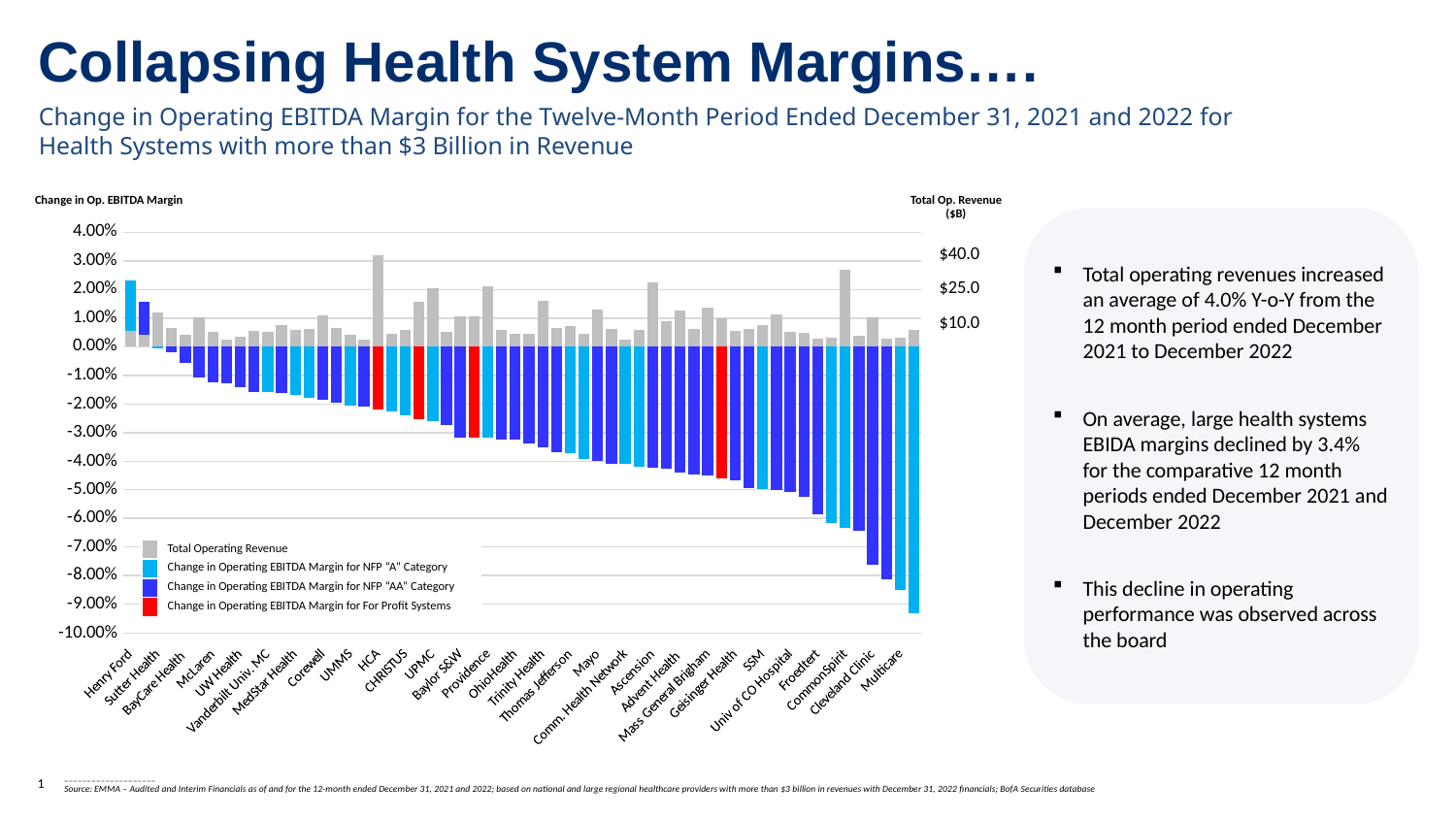
Is the total operating revenue for HCA greater or less than $25.0 billion? greater What colour represents the change in operating EBITDA margin for For Profit Systems in the legend? red Which is larger, the change in operating EBITDA margin for Henry Ford or for Multicare? Henry Ford How many series does the chart legend list? 4 Which health system has the highest change in operating EBITDA margin? Henry Ford What is the label of the right-hand vertical axis of the chart? Total Op. Revenue ($B) Is the change in operating EBITDA margin for Henry Ford greater or less than 1.00%? greater Do the change in operating EBITDA margin values rise or fall moving from left to right along the x axis? fall Is the change in operating EBITDA margin for Cleveland Clinic greater or less than -5.00%? less What kind of chart is shown on the slide? bar chart